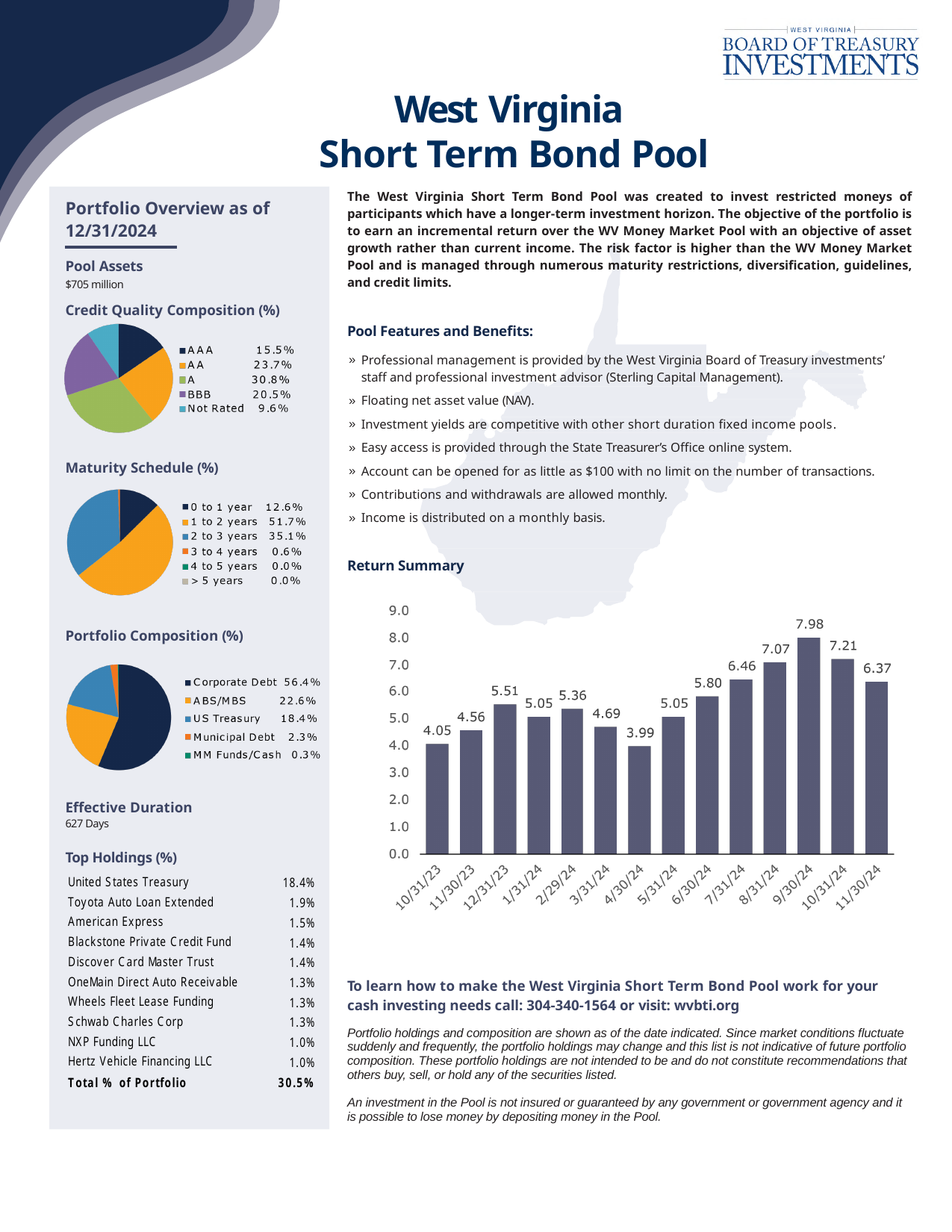
In the Return Summary chart, which is larger, the value for 6/30/24 or the value for 7/31/24? 7/31/24 How many categories does the legend of the Portfolio Composition pie chart list? 5 How many bars are plotted in the Return Summary chart? 14 What kind of chart is the Return Summary chart? bar chart In the Return Summary chart, which date has the lowest value? 4/30/24 In the Return Summary chart, which date has the highest value? 9/30/24 In the Maturity Schedule pie chart, what is the share for 1 to 2 years? 51.7% In the Portfolio Composition pie chart, which category has the smallest share? MM Funds/Cash In the Credit Quality Composition pie chart, what is the share for BBB? 20.5% In the Credit Quality Composition pie chart, which category has the largest share? A In the Return Summary chart, what is the difference between the values for 9/30/24 and 11/30/24? 1.61 In the Return Summary chart, what is the value for 9/30/24? 7.98